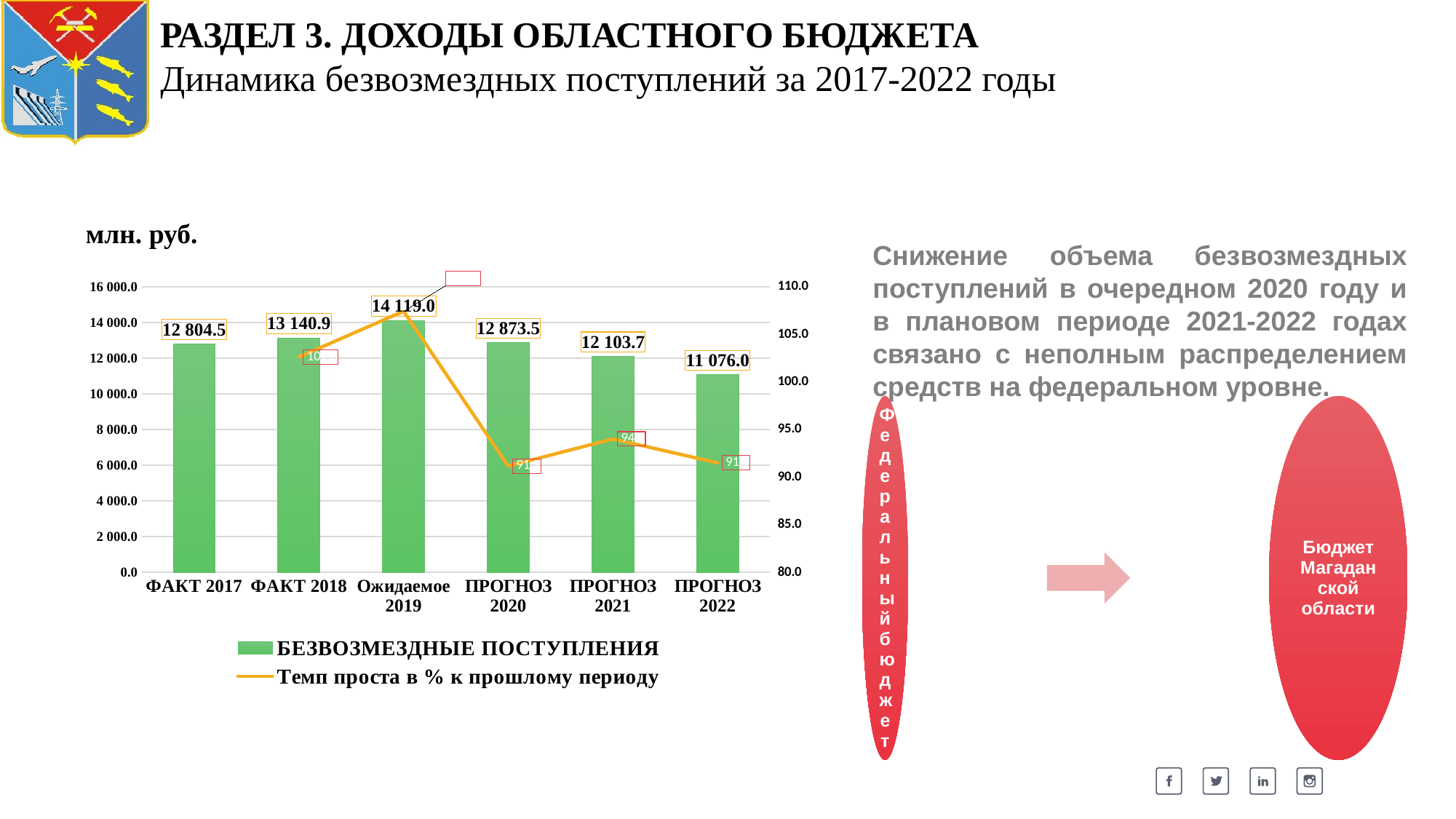
Do the БЕЗВОЗМЕЗДНЫЕ ПОСТУПЛЕНИЯ values rise or fall from Ожидаемое 2019 to ПРОГНОЗ 2022? fall What is the value of БЕЗВОЗМЕЗДНЫЕ ПОСТУПЛЕНИЯ for ПРОГНОЗ 2022? 11 076.0 What is the difference between the БЕЗВОЗМЕЗДНЫЕ ПОСТУПЛЕНИЯ values for Ожидаемое 2019 and ПРОГНОЗ 2022? 3 043.0 Which is larger, the БЕЗВОЗМЕЗДНЫЕ ПОСТУПЛЕНИЯ value for ПРОГНОЗ 2020 or for ПРОГНОЗ 2021? ПРОГНОЗ 2020 Is the value of Темп проста в % к прошлому периоду for ПРОГНОЗ 2020 greater or less than 95.0 on the right axis? less How many categories are shown on the x axis of the chart? 6 Which category has the lowest value of БЕЗВОЗМЕЗДНЫЕ ПОСТУПЛЕНИЯ? ПРОГНОЗ 2022 What is the difference between the БЕЗВОЗМЕЗДНЫЕ ПОСТУПЛЕНИЯ values for ФАКТ 2018 and ФАКТ 2017? 336.4 How many series does the chart legend list? 2 What is the value of БЕЗВОЗМЕЗДНЫЕ ПОСТУПЛЕНИЯ for ФАКТ 2017? 12 804.5 What is the value of БЕЗВОЗМЕЗДНЫЕ ПОСТУПЛЕНИЯ for Ожидаемое 2019? 14 119.0 Which category has the highest value of БЕЗВОЗМЕЗДНЫЕ ПОСТУПЛЕНИЯ? Ожидаемое 2019